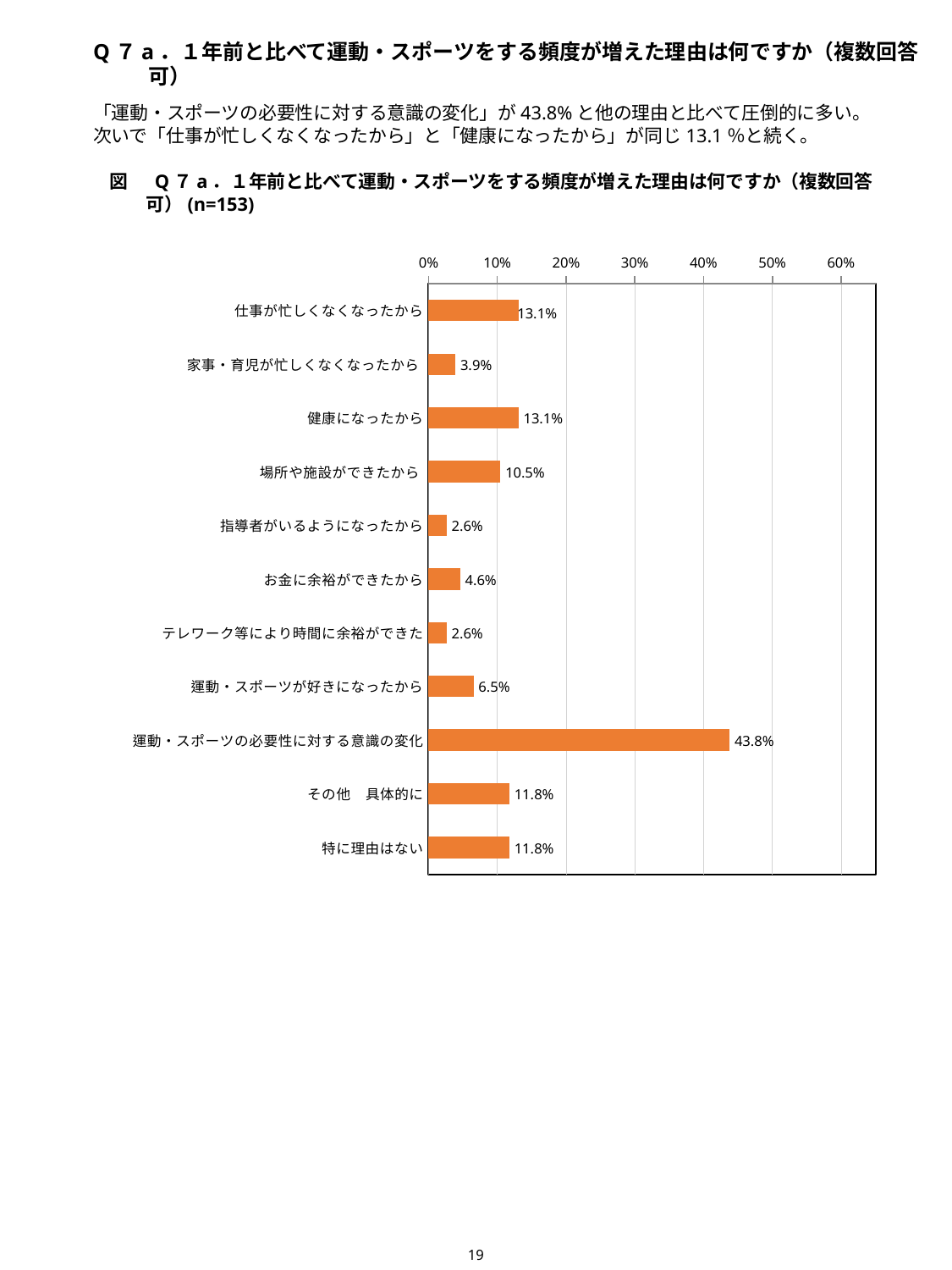
What is the sample size (n) shown in the chart title? 153 What is the value for その他 具体的に? 11.8% What is the value for 場所や施設ができたから? 10.5% Which category has the highest value? 運動・スポーツの必要性に対する意識の変化 What kind of chart is shown? bar chart What is the value for 運動・スポーツの必要性に対する意識の変化? 43.8% How many categories are shown in the chart? 11 What is the difference between 運動・スポーツが好きになったから and お金に余裕ができたから? 1.9% Is the value for 運動・スポーツの必要性に対する意識の変化 greater or less than 40%? greater What is the difference between 運動・スポーツの必要性に対する意識の変化 and 仕事が忙しくなくなったから? 30.7% What is the value for 家事・育児が忙しくなくなったから? 3.9% Which is larger, 場所や施設ができたから or 運動・スポーツが好きになったから? 場所や施設ができたから